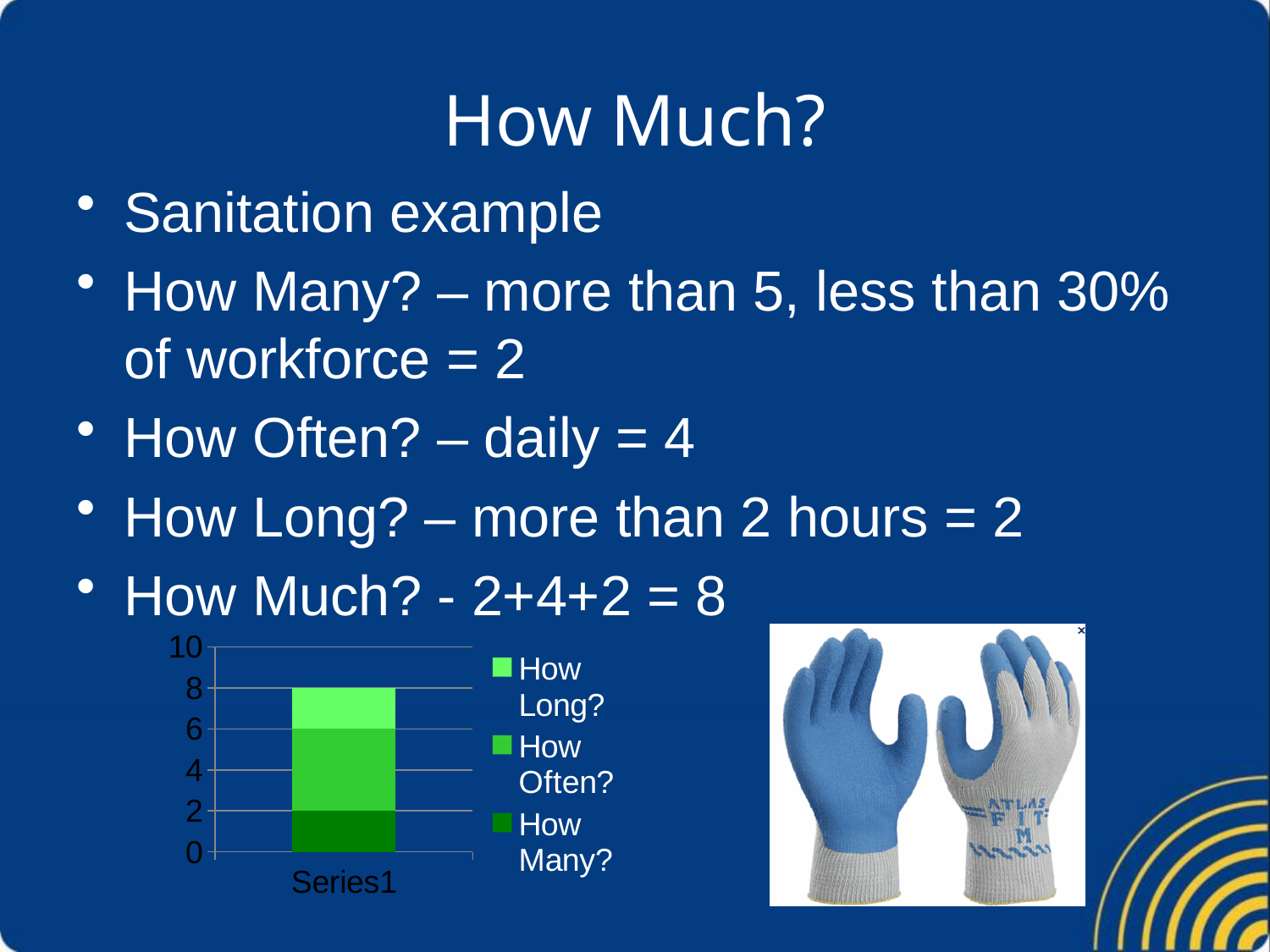
What is the value of the How Long? segment in the stacked bar? 2 Is the total height of the stacked bar greater or less than 6? greater What is the value of the How Many? segment in the stacked bar? 2 How many series does the chart legend list? 3 How many categories are plotted on the x axis of the chart? 1 What is the category label shown under the bar on the x axis? Series1 What is the total height of the stacked bar for Series1? 8 Which legend entry is listed first (at the top) in the chart legend? How Long? Which series contributes the largest segment to the stacked bar? How Often? Which is larger in the stacked bar, the How Often? segment or the How Many? segment? How Often? What kind of chart is shown on the slide? bar chart What is the value of the How Often? segment in the stacked bar? 4